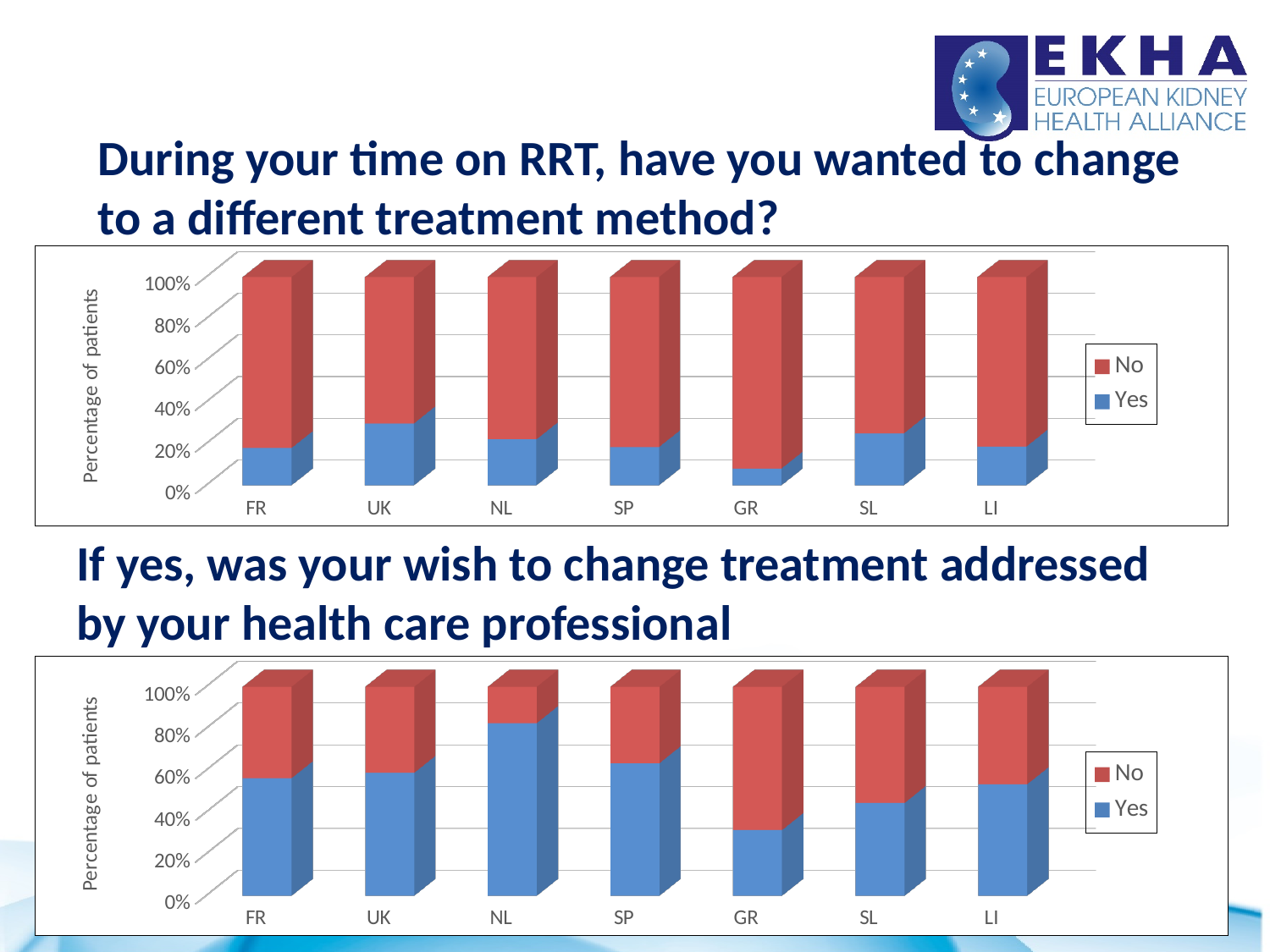
How many series does the legend of the bottom chart list? 2 In the top chart, is the 'Yes' share for GR greater or less than 20%? less How many countries are shown on the x axis of the top chart? 7 In the bottom chart, is the 'Yes' share for NL greater or less than 80%? greater In the bottom chart, which has the larger 'Yes' share, SP or SL? SP In the bottom chart (If yes, was your wish to change treatment addressed by your health care professional), which country has the highest share of 'Yes' responses? NL What type of chart is the top chart? Stacked bar chart In the top chart, is the 'Yes' share for UK greater or less than 20%? greater In the top chart, which has the larger 'Yes' share, UK or GR? UK In the top chart (During your time on RRT, have you wanted to change to a different treatment method?), which country has the lowest share of 'Yes' responses? GR In the bottom chart, which country has the lowest share of 'Yes' responses? GR